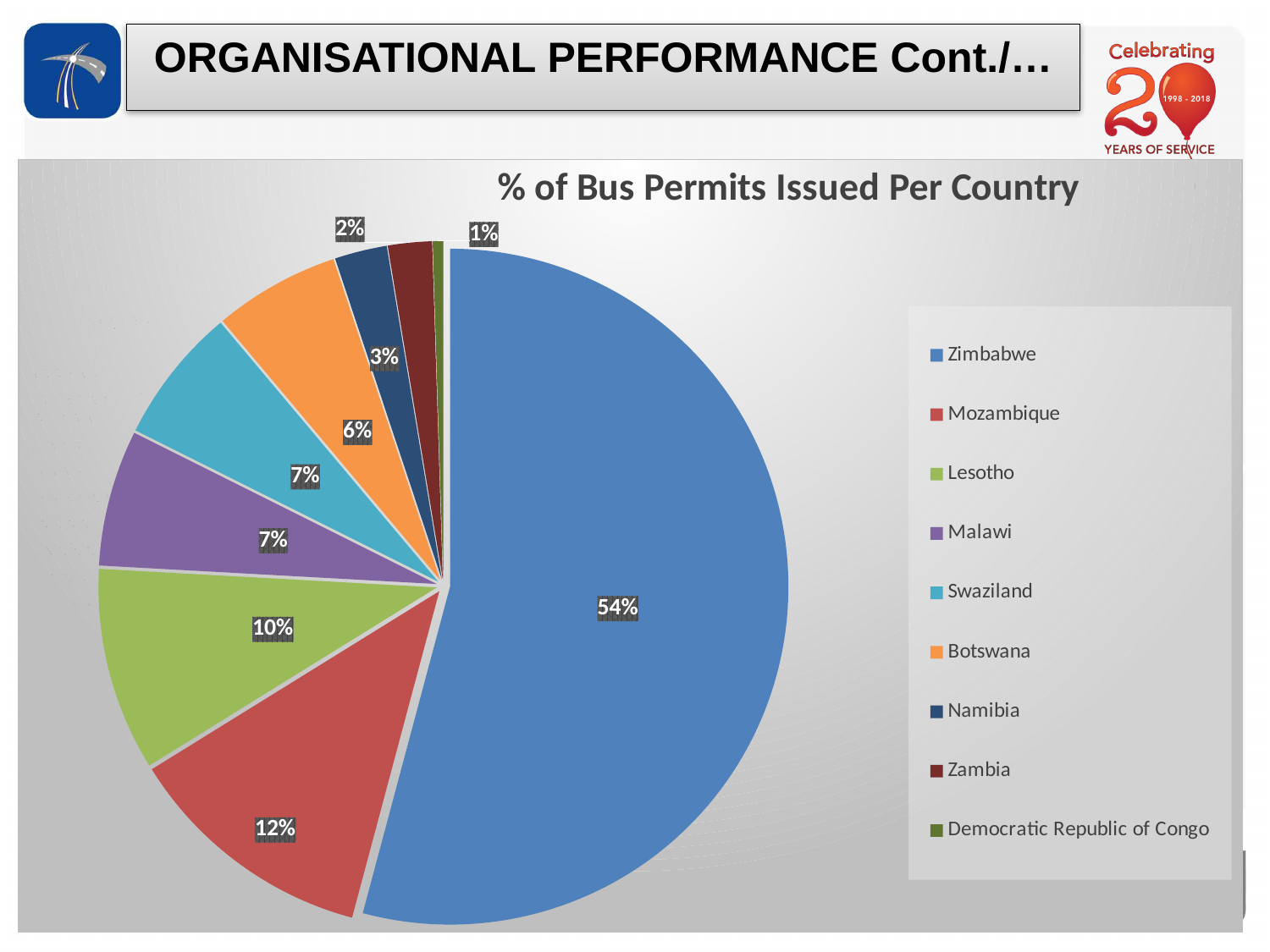
Which has a larger share of bus permits, Lesotho or Botswana? Lesotho What is the title of the chart? % of Bus Permits Issued Per Country Which country has the largest share of bus permits issued? Zimbabwe What type of chart is shown on the slide? pie chart What share of bus permits was issued for Botswana? 6% What share of bus permits was issued for Namibia? 3% What is the difference in percentage points between Zimbabwe's share and Mozambique's share? 42 Which country has the smallest share of bus permits issued? Democratic Republic of Congo How many countries are listed in the chart legend? 9 What share of bus permits was issued for Zimbabwe? 54%